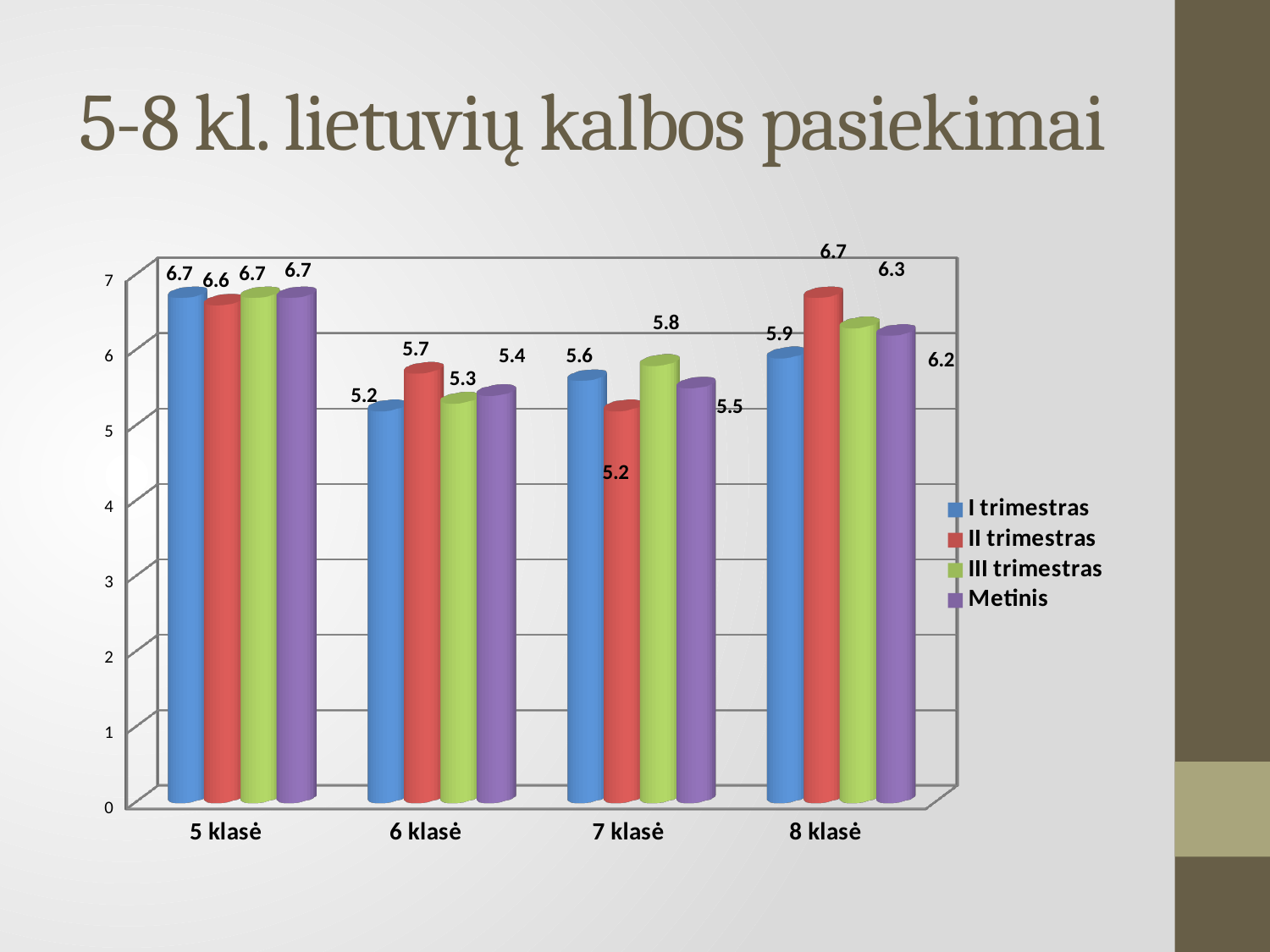
Which is larger: the III trimestras value for 7 klasė or for 6 klasė? 7 klasė What is the value for III trimestras in 8 klasė? 6.3 What is the difference between the II trimestras values for 8 klasė and 7 klasė? 1.5 How many classes are shown on the x axis? 4 What is the title of the slide? 5-8 kl. lietuvių kalbos pasiekimai What kind of chart is shown on the slide? Bar chart What is the Metinis value for 7 klasė? 5.5 How many series does the legend list? 4 What is the value for I trimestras in 5 klasė? 6.7 Which class has the lowest I trimestras value? 6 klasė What is the value for II trimestras in 6 klasė? 5.7 Which class has the highest Metinis value? 5 klasė